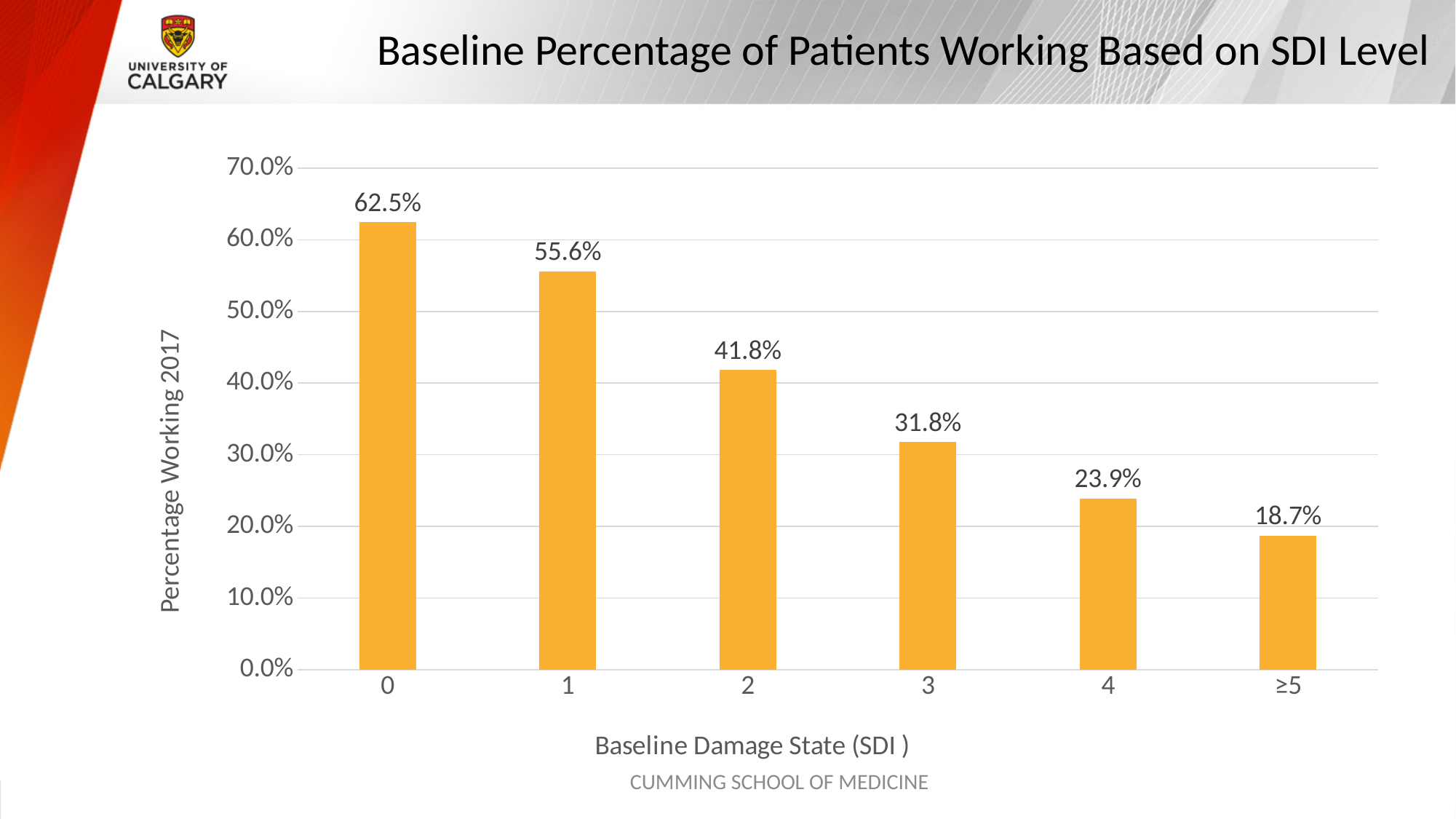
Which SDI level has the highest percentage of patients working? 0 What is the percentage of patients working at baseline for SDI level 2? 41.8% What is the difference in percentage working between SDI level 3 and SDI level 4? 7.9% Which SDI level has the lowest percentage of patients working? ≥5 What is the percentage of patients working at baseline for SDI level 0? 62.5% Which has a higher percentage working, SDI level 1 or SDI level 3? SDI level 1 What is the percentage of patients working at baseline for SDI level ≥5? 18.7% How many SDI level categories are shown on the x axis? 6 What kind of chart is shown on the slide? Bar chart Is the percentage working for SDI level 4 greater or less than 30.0%? less What is the difference in percentage working between SDI level 0 and SDI level 1? 6.9% Does the percentage working rise or fall as the SDI level increases along the x axis? Fall